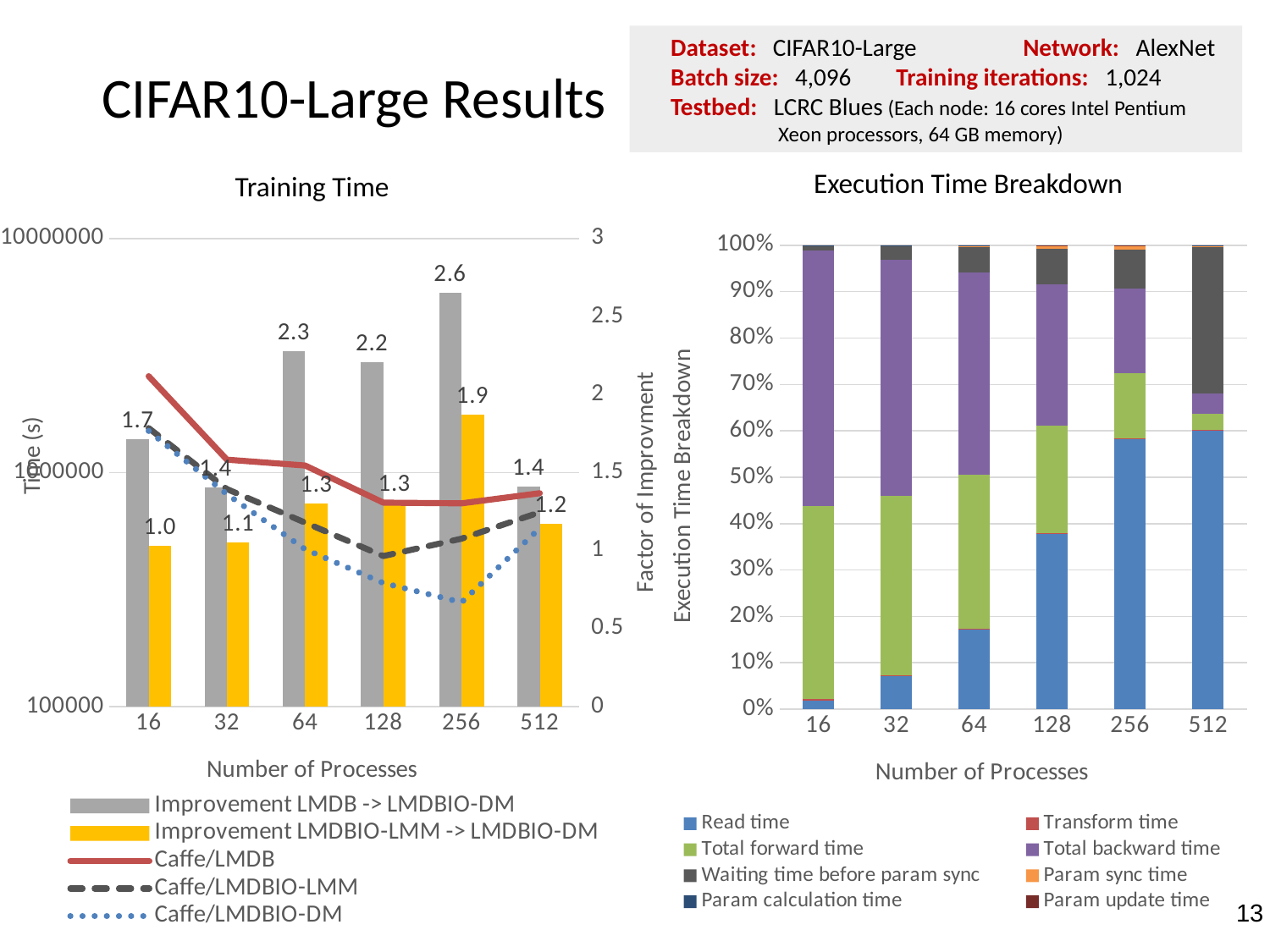
On the Training Time chart, at which number of processes is Improvement LMDB -> LMDBIO-DM highest? 256 On the Training Time chart, what is the difference between Improvement LMDB -> LMDBIO-DM and Improvement LMDBIO-LMM -> LMDBIO-DM at 64 processes? 1.0 On the Training Time chart, which is larger at 512 processes: Improvement LMDB -> LMDBIO-DM or Improvement LMDBIO-LMM -> LMDBIO-DM? Improvement LMDB -> LMDBIO-DM On the Training Time chart, at which number of processes is Improvement LMDBIO-LMM -> LMDBIO-DM lowest? 16 On the Execution Time Breakdown chart, does the Read time share rise or fall as the number of processes increases? rise How many series does the legend of the Execution Time Breakdown chart list? 8 On the Execution Time Breakdown chart, is the Read time share at 256 processes greater or less than 50%? greater How many series does the legend of the Training Time chart list? 5 How many numbers of processes are shown on the x axis of the Execution Time Breakdown chart? 6 On the Training Time chart, what is the value of Improvement LMDBIO-LMM -> LMDBIO-DM at 256 processes? 1.9 On the Training Time chart, what is the value of Improvement LMDB -> LMDBIO-DM at 256 processes? 2.6 On the Training Time chart, what is the value of Improvement LMDBIO-LMM -> LMDBIO-DM at 16 processes? 1.0